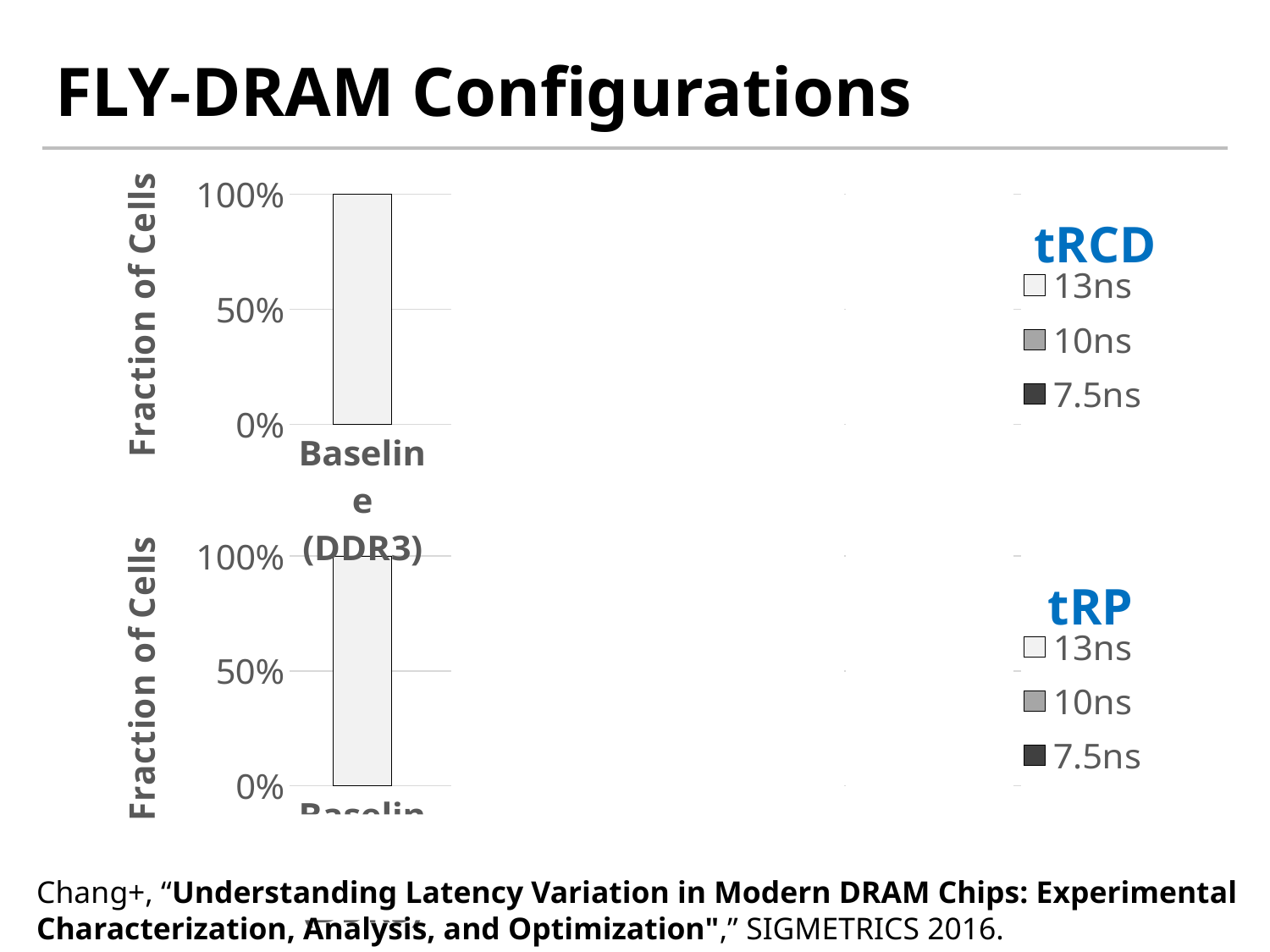
In the bottom chart (tRP), is the value of the plotted bar greater or less than 50%? greater How many bars are plotted in the bottom chart (tRP)? 1 What kind of chart is the bottom chart (tRP)? bar chart In the bottom chart (tRP), what Fraction of Cells does the single plotted bar reach? 100% How many series does the legend of the bottom chart (tRP) list? 3 How many series does the legend of the top chart (tRCD) list? 3 What are the three legend entries of the bottom chart (tRP)? 13ns, 10ns, 7.5ns In the top chart (tRCD), what is the Fraction of Cells for Baseline (DDR3)? 100% In the top chart (tRCD), is the value for Baseline (DDR3) greater or less than 50%? greater How many categories are plotted on the x axis of the top chart (tRCD)? 1 What is the y-axis label of the top chart (tRCD)? Fraction of Cells What kind of chart is the top chart (tRCD)? bar chart